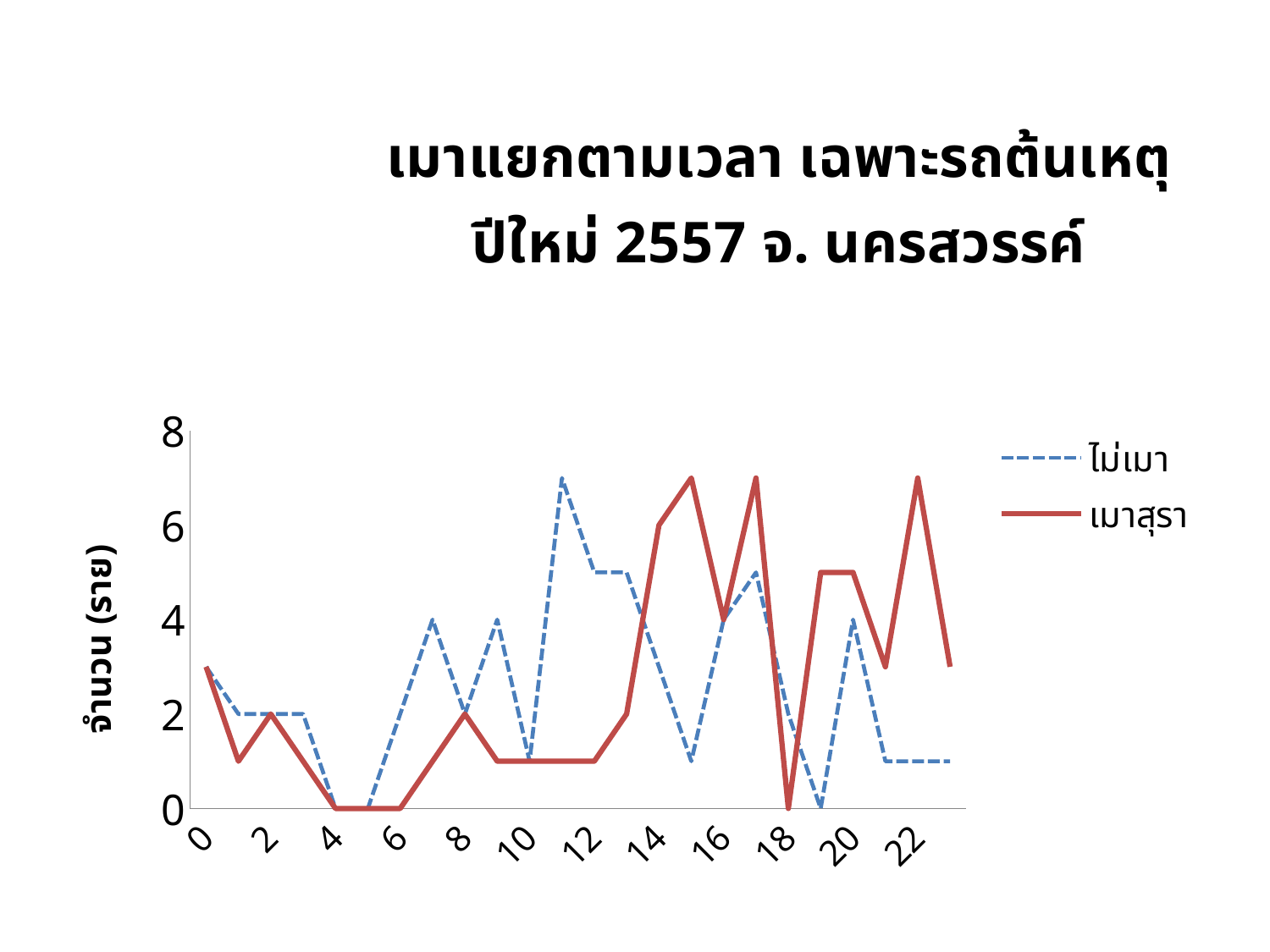
At hour 11, which series has the larger value, ไม่เมา or เมาสุรา? ไม่เมา What kind of chart is shown on the slide? line chart What is the value of the เมาสุรา series at hour 18? 0 What is the label on the vertical axis? จำนวน (ราย) What are the two series named in the legend? ไม่เมา and เมาสุรา At which hour does the ไม่เมา series reach its highest value? 11 At hour 15, which series has the larger value, ไม่เมา or เมาสุรา? เมาสุรา Is the value of the เมาสุรา series at hour 22 greater or less than 6? greater Is the value of the เมาสุรา series at hour 12 greater or less than 2? less How many series does the legend list? 2 What is the value of the เมาสุรา series at hour 14? 6 What is the value of the ไม่เมา series at hour 7? 4